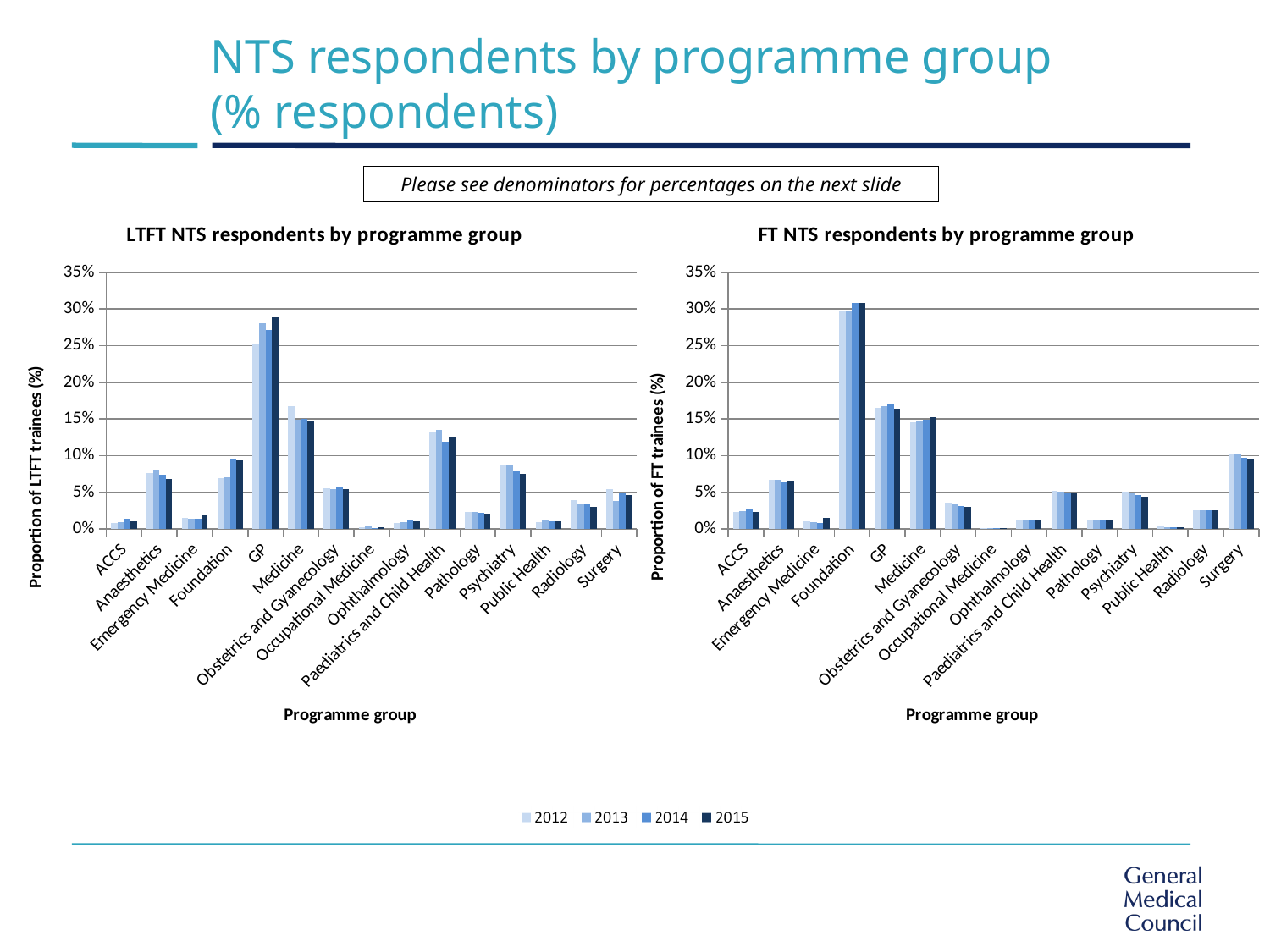
How many series does the legend list for the charts? 4 In the FT NTS respondents by programme group chart, which programme group has the highest proportion of trainees? Foundation In the LTFT NTS respondents by programme group chart, is the 2015 value for GP greater or less than 25%? greater What is the y-axis title of the FT NTS respondents by programme group chart? Proportion of FT trainees (%) In the FT NTS respondents by programme group chart, which programme group has the lowest proportion of trainees? Occupational Medicine In the LTFT NTS respondents by programme group chart, is the 2012 value for Paediatrics and Child Health greater or less than 10%? greater In the LTFT NTS respondents by programme group chart, which is larger in 2015: Anaesthetics or Foundation? Foundation How many programme groups are shown on the x axis of the FT NTS respondents by programme group chart? 15 In the FT NTS respondents by programme group chart, is the 2013 value for Surgery greater or less than 15%? less What kind of chart is the LTFT NTS respondents by programme group chart? bar chart In the FT NTS respondents by programme group chart, which is larger in 2012: GP or Medicine? GP In the LTFT NTS respondents by programme group chart, which programme group has the highest proportion of trainees? GP